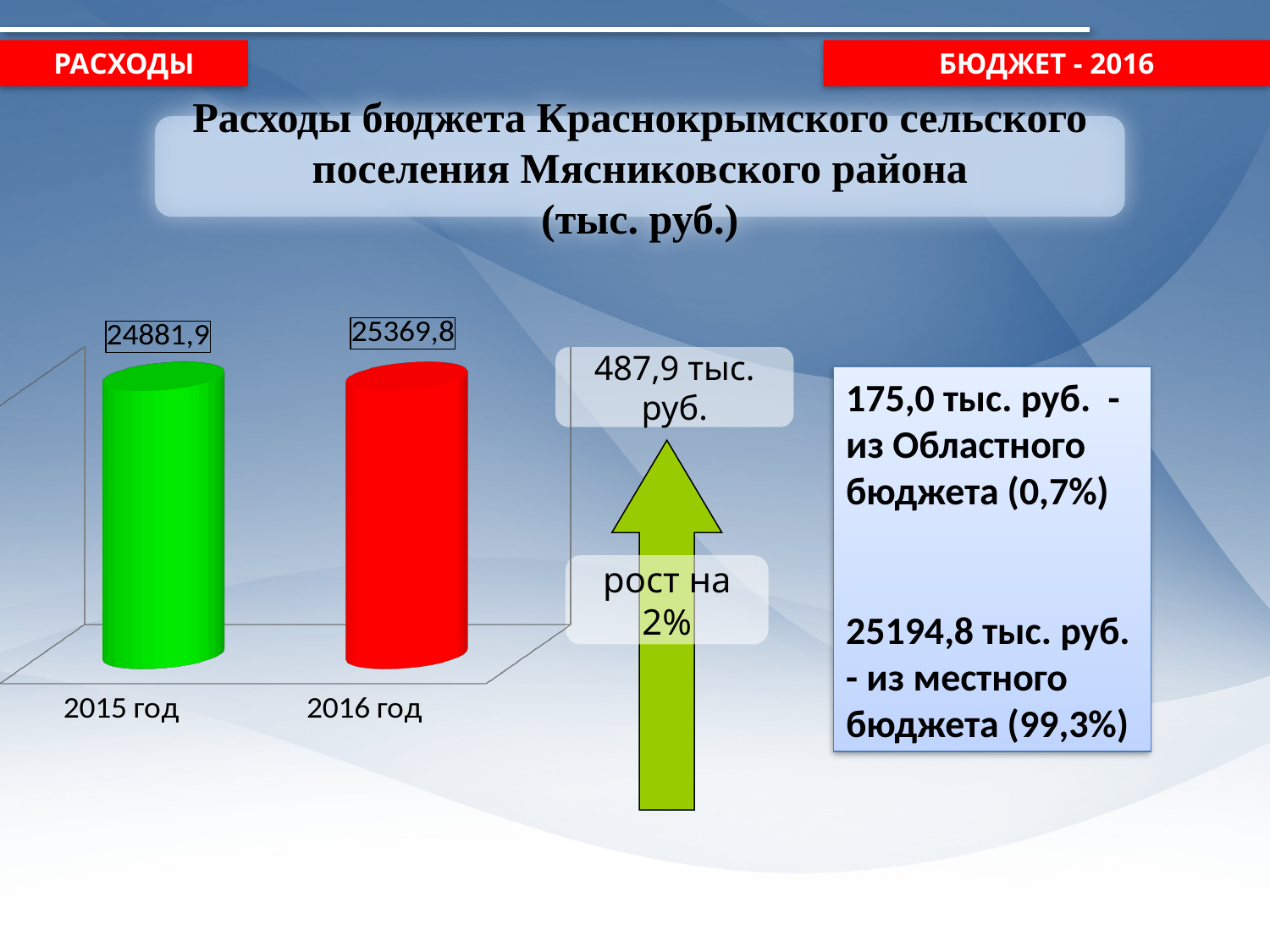
How many categories are shown in the chart? 2 What colour is the bar for 2016 год? red Which category has the highest value? 2016 год What is the value for 2015 год? 24881,9 What colour is the bar for 2015 год? green What is the value for 2016 год? 25369,8 What is the difference between the values for 2016 год and 2015 год? 487,9 Which year has the higher value, 2015 год or 2016 год? 2016 год What kind of chart is shown on the slide? bar chart Which category has the lowest value? 2015 год Do the values rise or fall from 2015 год to 2016 год? rise